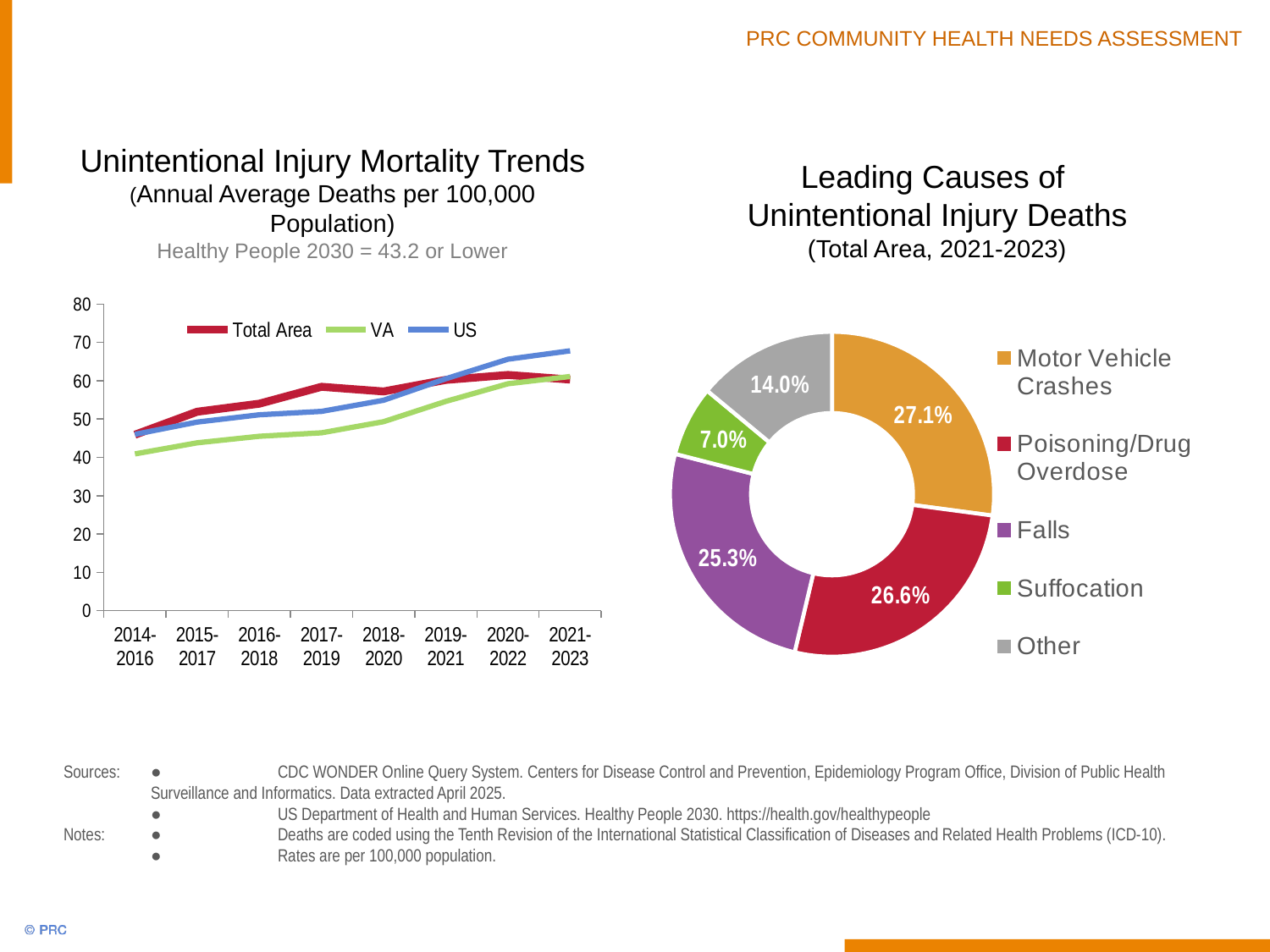
How many series does the legend of the Unintentional Injury Mortality Trends chart list? 3 In the Unintentional Injury Mortality Trends chart, is the VA value for 2014-2016 greater or less than 50? less In the Leading Causes of Unintentional Injury Deaths chart, what share is Falls? 25.3% In the Leading Causes of Unintentional Injury Deaths chart, which cause has the smallest share? Suffocation In the Leading Causes of Unintentional Injury Deaths chart, what share is Poisoning/Drug Overdose? 26.6% In the Leading Causes of Unintentional Injury Deaths chart, which cause has the largest share? Motor Vehicle Crashes In the Unintentional Injury Mortality Trends chart, does the VA line generally rise or fall from 2014-2016 to 2021-2023? rise In the Leading Causes of Unintentional Injury Deaths chart, what share is Motor Vehicle Crashes? 27.1% How many categories are shown in the Leading Causes of Unintentional Injury Deaths chart? 5 What kind of chart is the Leading Causes of Unintentional Injury Deaths chart? Donut (pie) chart In the Leading Causes of Unintentional Injury Deaths chart, what is the difference between the Other share and the Suffocation share? 7.0% In the Unintentional Injury Mortality Trends chart, is the US value for 2021-2023 greater or less than 60? greater